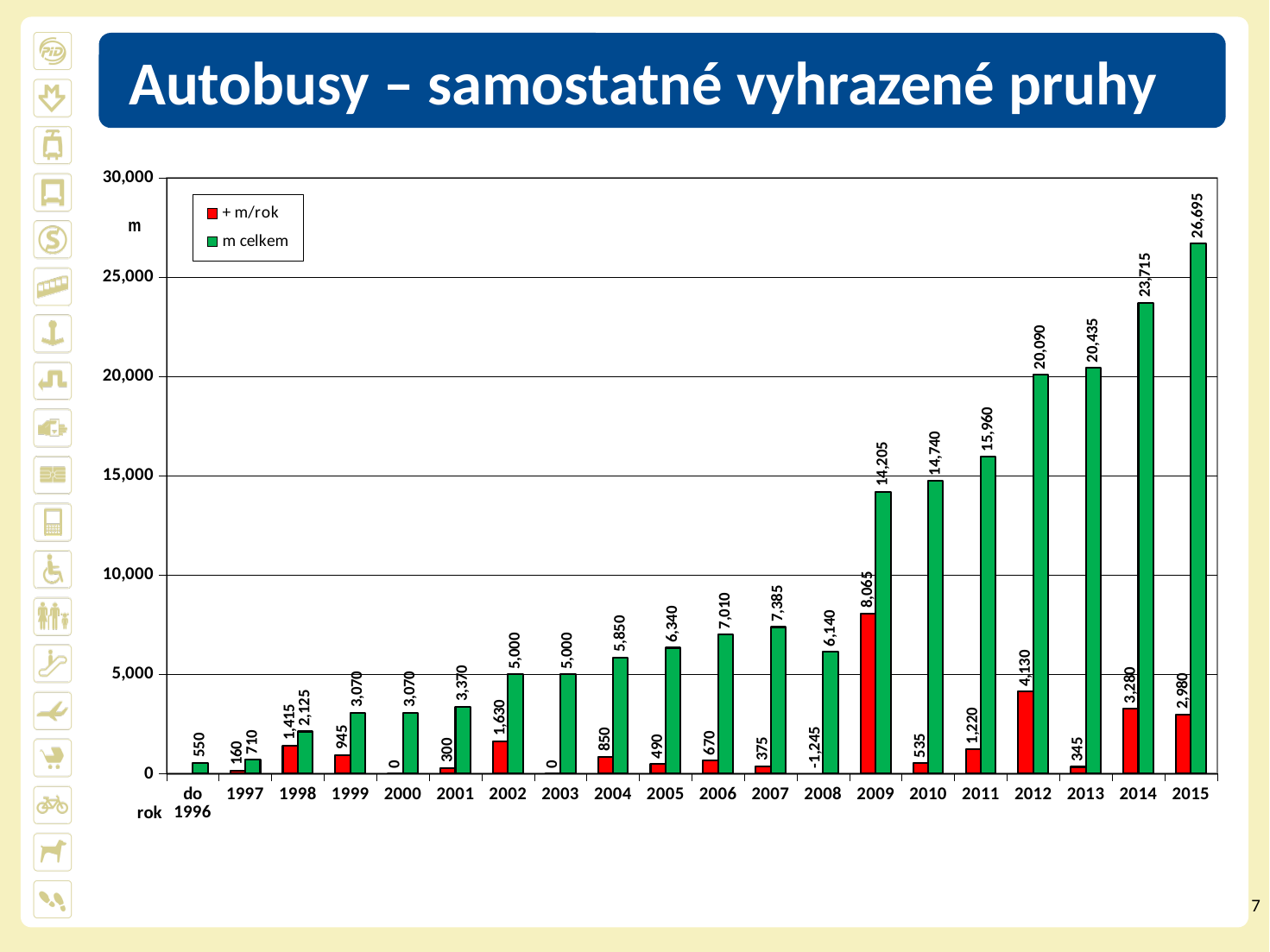
Which year has the highest "+ m/rok" value? 2009 What is the value of "+ m/rok" for 2008? -1,245 How many series does the legend list? 2 What is the difference between the "m celkem" values for 2015 and 2014? 2,980 What kind of chart is shown on the slide? bar chart Does the "m celkem" series rise or fall from 2009 to 2015? rise Which is larger, the "+ m/rok" value for 2012 or for 2014? 2012 What is the value of "m celkem" for 2008? 6,140 Is the "m celkem" value for 2011 greater or less than 15,000? greater What is the value of "+ m/rok" for 2009? 8,065 Which year has the lowest "+ m/rok" value? 2008 What is the value of "m celkem" for 2015? 26,695